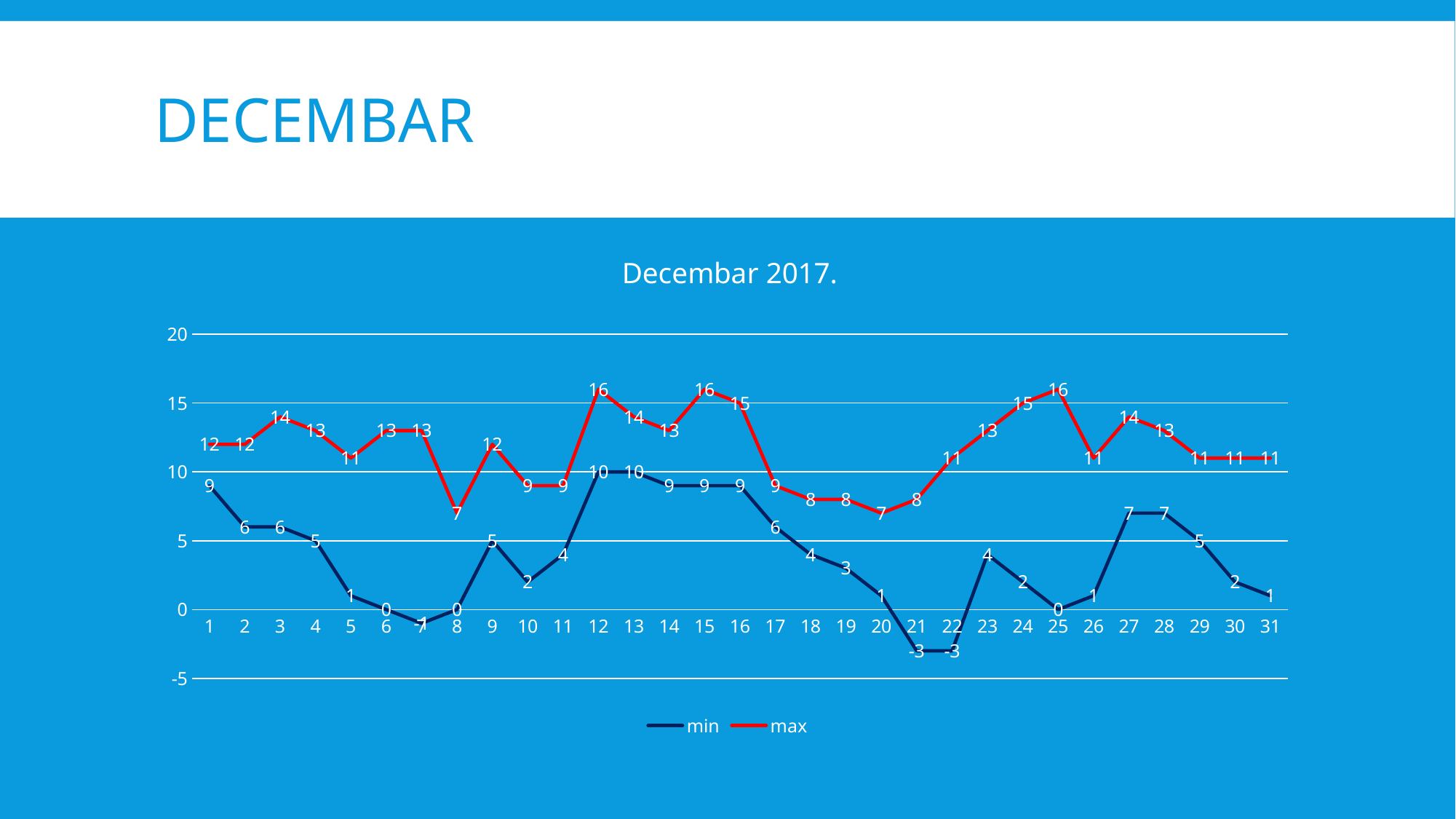
What is the min value on day 21? -3 Does the min series rise or fall from day 17 to day 21? fall What is the difference between the max and min values on day 8? 7 What is the highest value reached by the max series? 16 Which is larger, the max value on day 3 or the max value on day 5? day 3 What is the title of the chart? Decembar 2017. What is the max value on day 12? 16 What is the min value on day 7? -1 What is the difference between the max and min values on day 1? 3 How many series does the legend list? 2 What kind of chart is shown? line chart How many days are plotted on the x axis? 31